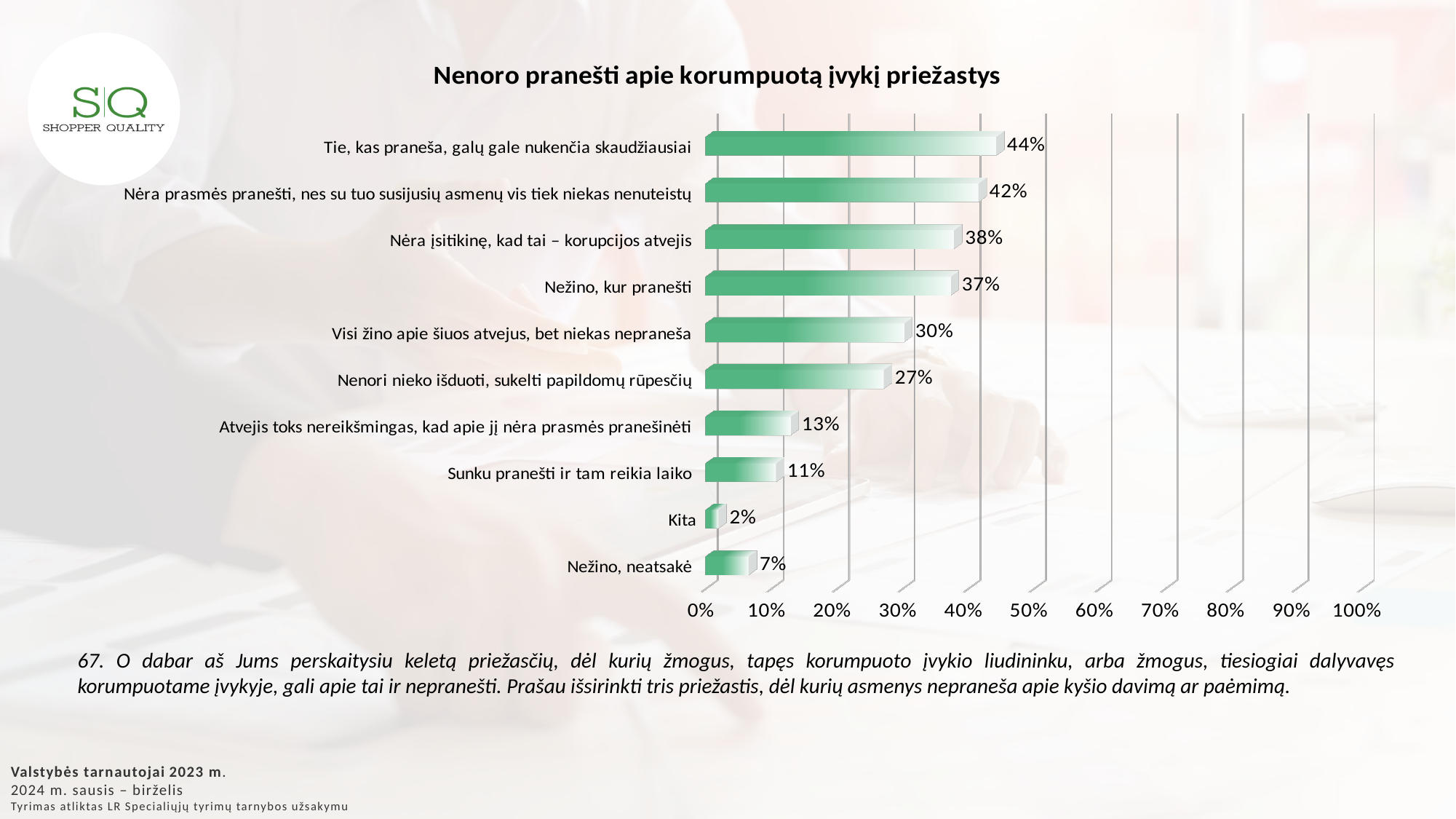
What is the difference between "Tie, kas praneša, galų gale nukenčia skaudžiausiai" and "Nėra prasmės pranešti, nes su tuo susijusių asmenų vis tiek niekas nenuteistų"? 2% What is the value for "Sunku pranešti ir tam reikia laiko"? 11% What is the title of the chart? Nenoro pranešti apie korumpuotą įvykį priežastys Which is larger: the value for "Atvejis toks nereikšmingas, kad apie jį nėra prasmės pranešinėti" or the value for "Nežino, neatsakė"? Atvejis toks nereikšmingas, kad apie jį nėra prasmės pranešinėti What is the value for "Nežino, kur pranešti"? 37% What kind of chart is shown on the slide? Bar chart What is the value for "Kita"? 2% Is the value for "Nėra įsitikinę, kad tai – korupcijos atvejis" greater or less than 30%? greater Which category has the lowest value? Kita Which category has the highest value? Tie, kas praneša, galų gale nukenčia skaudžiausiai How many categories are shown in the chart? 10 What is the difference between "Visi žino apie šiuos atvejus, bet niekas nepraneša" and "Nenori nieko išduoti, sukelti papildomų rūpesčių"? 3%